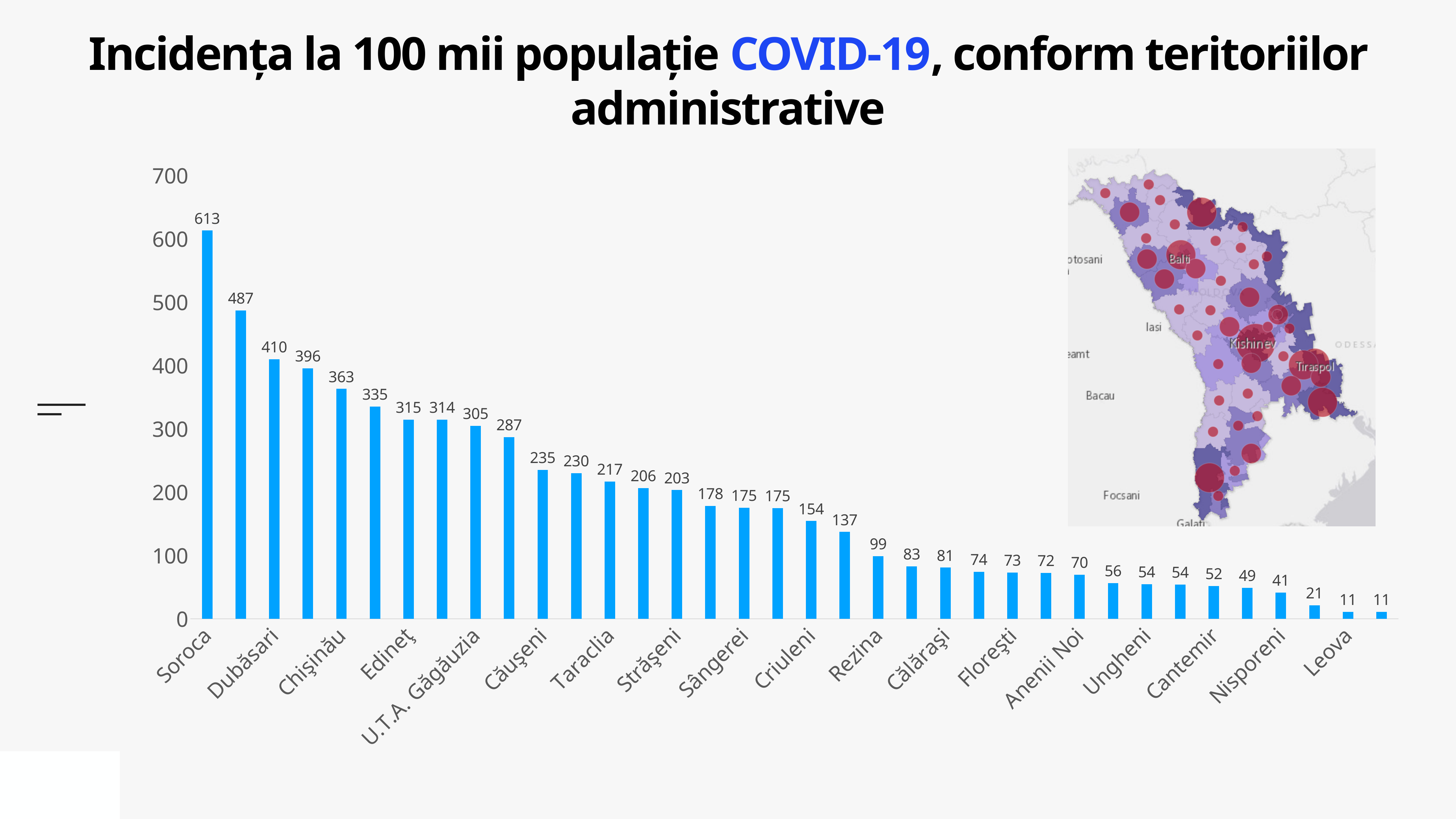
What is the incidence value for Rezina? 99 What is the lowest value shown on the chart? 11 What is the difference between the values for Soroca and Dubăsari? 203 What is the incidence value for Soroca? 613 Which has a higher value, Chișinău or Edineț? Chișinău Is the value for Rezina greater or less than 100? less What kind of chart is shown on the slide? bar chart Do the values rise or fall from left to right along the x axis? fall Which territory has the highest incidence? Soroca What is the incidence value for Dubăsari? 410 What is the incidence value for Chișinău? 363 How many bars are plotted on the chart? 36